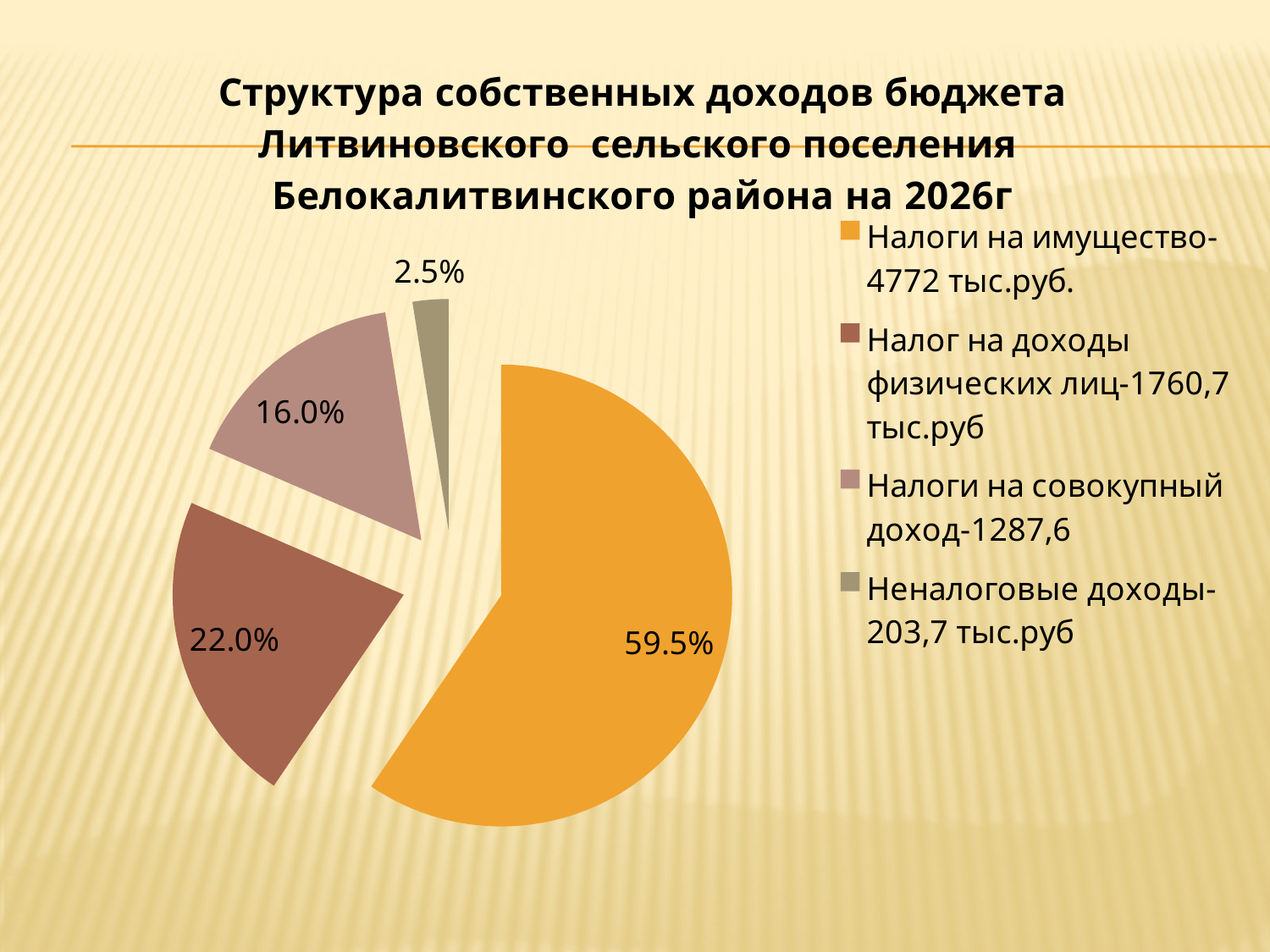
What colour is the slice for "Неналоговые доходы"? grey-olive According to the legend, what amount in тыс.руб. corresponds to "Налоги на имущество"? 4772 тыс.руб. What share of the pie does "Налог на доходы физических лиц" take? 22.0% What is the difference in percentage points between the shares of "Налог на доходы физических лиц" and "Налоги на совокупный доход"? 6.0 What share of the pie does "Налоги на имущество" take? 59.5% What share of the pie does "Налоги на совокупный доход" take? 16.0% Which slice is larger: "Налоги на совокупный доход" or "Неналоговые доходы"? Налоги на совокупный доход Which category has the smallest slice of the pie? Неналоговые доходы What kind of chart is shown on the slide? pie chart Which category has the largest slice of the pie? Налоги на имущество How many slices does the pie chart have? 4